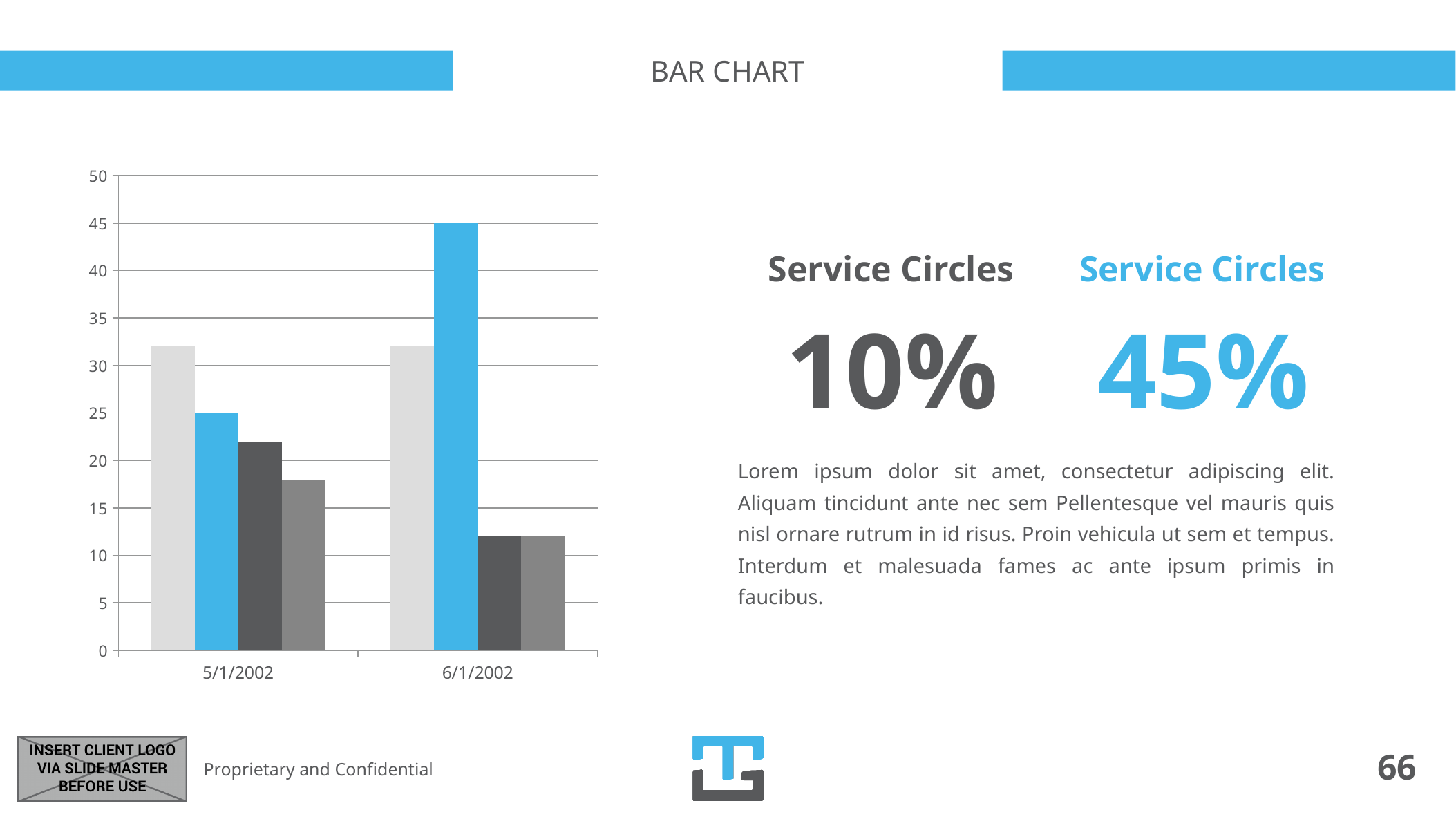
How many categories are shown on the x axis of the chart? 2 By how much does the blue bar for 6/1/2002 exceed the blue bar for 5/1/2002? 20 What is the highest value shown on the chart's vertical axis? 50 What is the value of the blue bar for 5/1/2002? 25 Do the blue bars rise or fall from 5/1/2002 to 6/1/2002? rise What is the value of the blue bar for 6/1/2002? 45 For 6/1/2002, which is larger: the blue bar or the light grey bar? the blue bar Is the value of the dark grey bar for 6/1/2002 greater or less than 15? less Which category contains the tallest bar in the chart? 6/1/2002 Is the value of the light grey bar for 5/1/2002 greater or less than 30? greater How many bars are plotted for each category in the chart? 4 What kind of chart is shown on the slide? bar chart